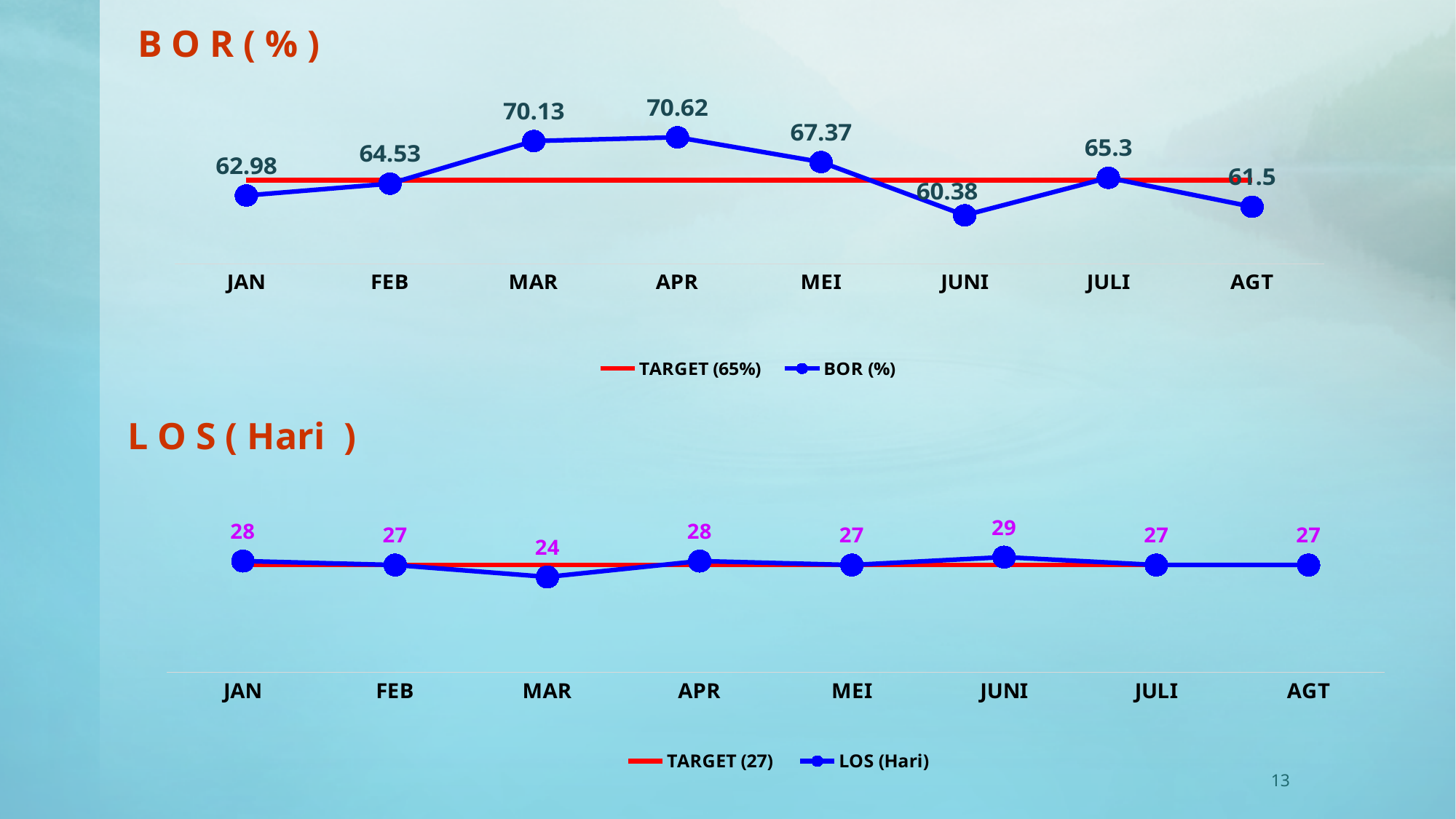
In the LOS (Hari) chart, what is the difference between the LOS values for JUNI and MAR? 5 In the LOS (Hari) chart, how many months are plotted on the x axis? 8 In the BOR (%) chart, what is the BOR value for APR? 70.62 What kind of chart is the LOS (Hari) chart? line chart In the BOR (%) chart, how many series does the legend list? 2 In the BOR (%) chart, which month has the highest BOR value? APR In the LOS (Hari) chart, which month has the highest LOS value? JUNI In the LOS (Hari) chart, what is the LOS value for MAR? 24 In the BOR (%) chart, is the BOR value for MEI larger or smaller than the value for JULI? larger In the BOR (%) chart, what is the difference between the BOR values for MAR and JAN? 7.15 In the BOR (%) chart, which month has the lowest BOR value? JUNI In the BOR (%) chart, what is the BOR value for AGT? 61.5